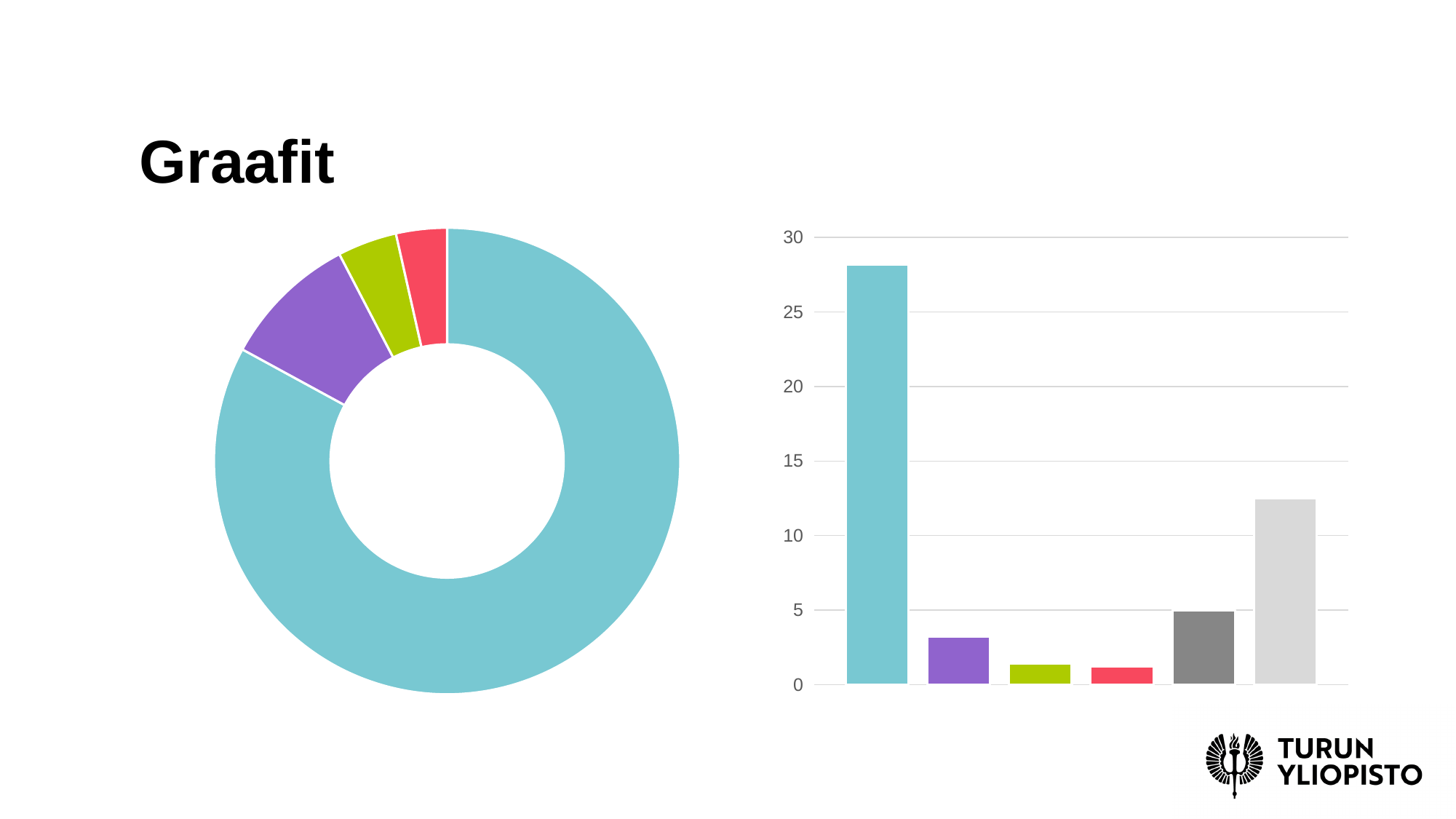
In the bar chart on the right, is the value of the first (teal) bar greater or less than 25? greater How many slices does the doughnut chart on the left have? 4 What kind of chart is shown on the right side of the slide? Bar chart How many bars does the bar chart on the right have? 6 What is the title of the slide? Graafit In the bar chart on the right, which bar is the tallest? The first (teal) bar In the bar chart on the right, which is larger: the first (teal) bar or the last (light grey) bar? The first (teal) bar In the bar chart on the right, is the value of the last (light grey) bar greater or less than 10? greater In the bar chart on the right, is the value of the second (purple) bar greater or less than 5? less In the bar chart on the right, which is larger: the purple bar or the dark grey bar? The dark grey bar In the doughnut chart on the left, which slice is the largest? The teal slice What kind of chart is shown on the left side of the slide? Doughnut (pie) chart